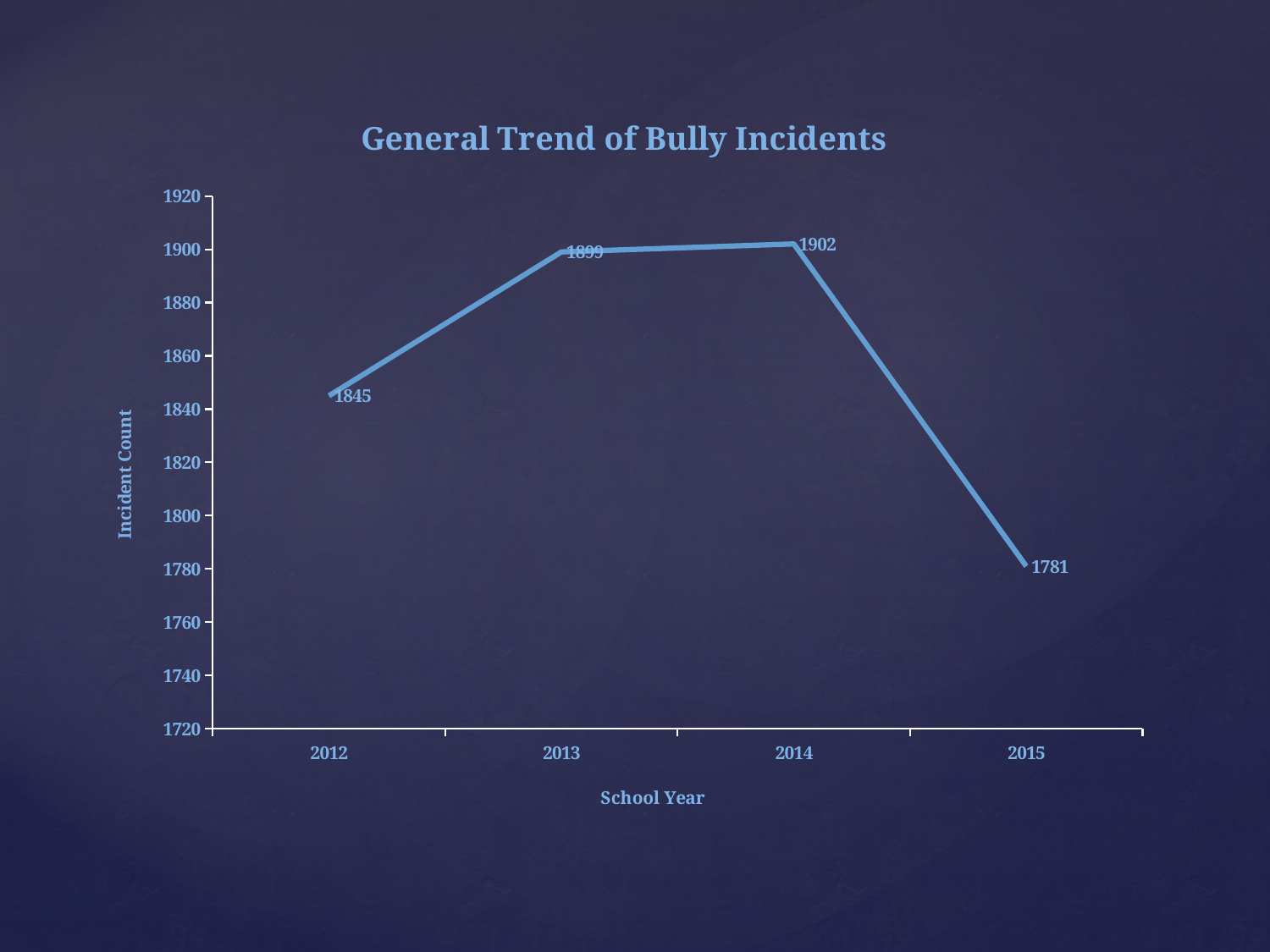
What is the difference between the incident counts for 2014 and 2015? 121 How many school years are plotted on the chart? 4 What is the incident count for 2015? 1781 Is the value for 2013 greater or less than 1880? greater Which school year has the highest incident count? 2014 What is the incident count for 2012? 1845 What is the title of the chart? General Trend of Bully Incidents What is the incident count for 2014? 1902 Which is larger, the incident count for 2012 or for 2015? 2012 What is the difference between the incident counts for 2013 and 2012? 54 Which school year has the lowest incident count? 2015 What kind of chart is shown on the slide? line chart